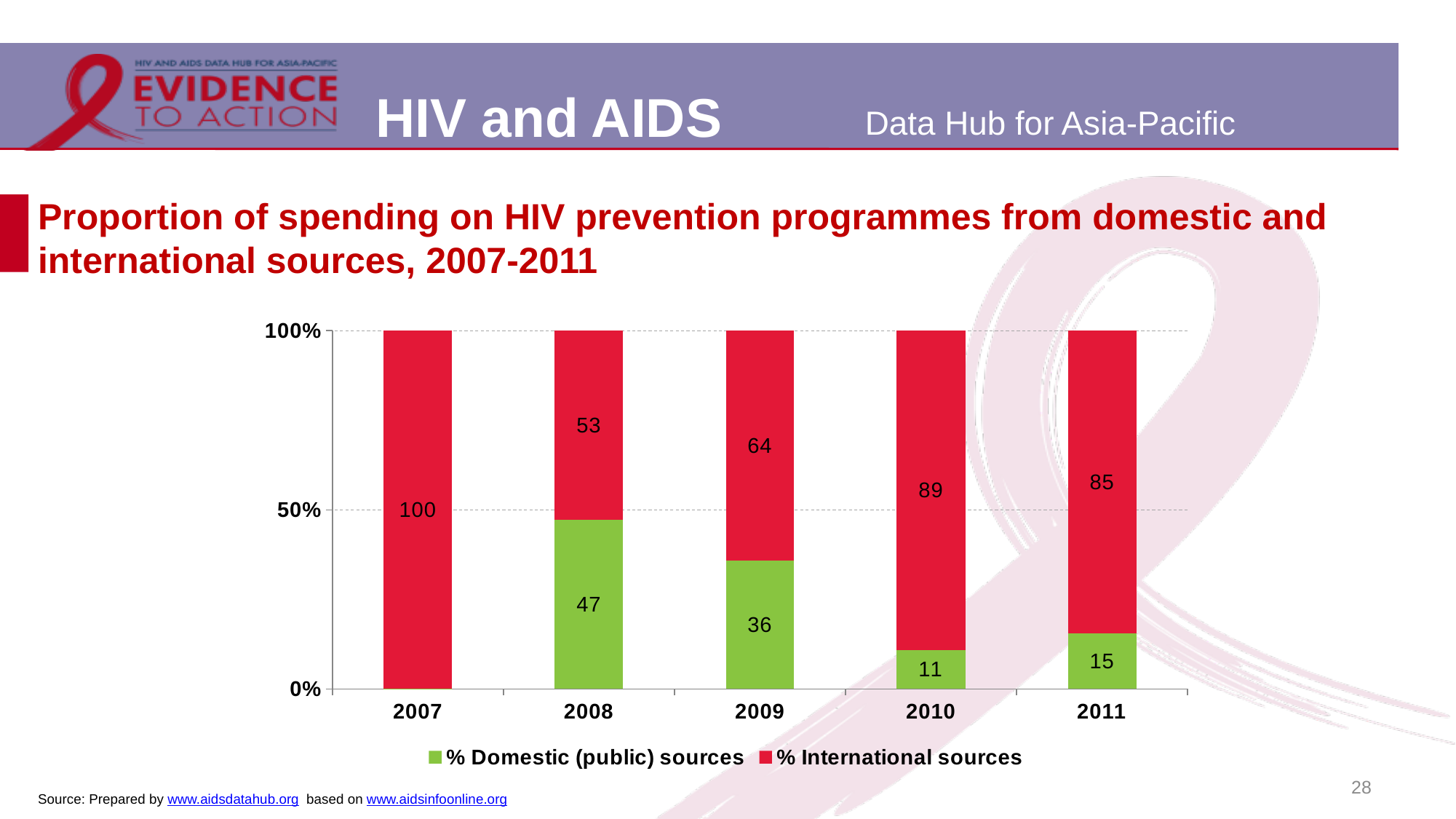
What is the value for % International sources in 2009? 64 What is the value for % Domestic (public) sources in 2011? 15 In which year is the % International sources value lowest? 2008 In which year is the % Domestic (public) sources value highest? 2008 What is the value for % International sources in 2007? 100 Which is larger: the % Domestic (public) sources value for 2009 or for 2010? 2009 What is the value for % Domestic (public) sources in 2008? 47 What is the difference between the % International sources values for 2010 and 2011? 4 How many series does the legend list? 2 How many years are shown on the x axis? 5 Which colour represents % International sources in the chart? Red What kind of chart is shown on the slide? Stacked bar chart